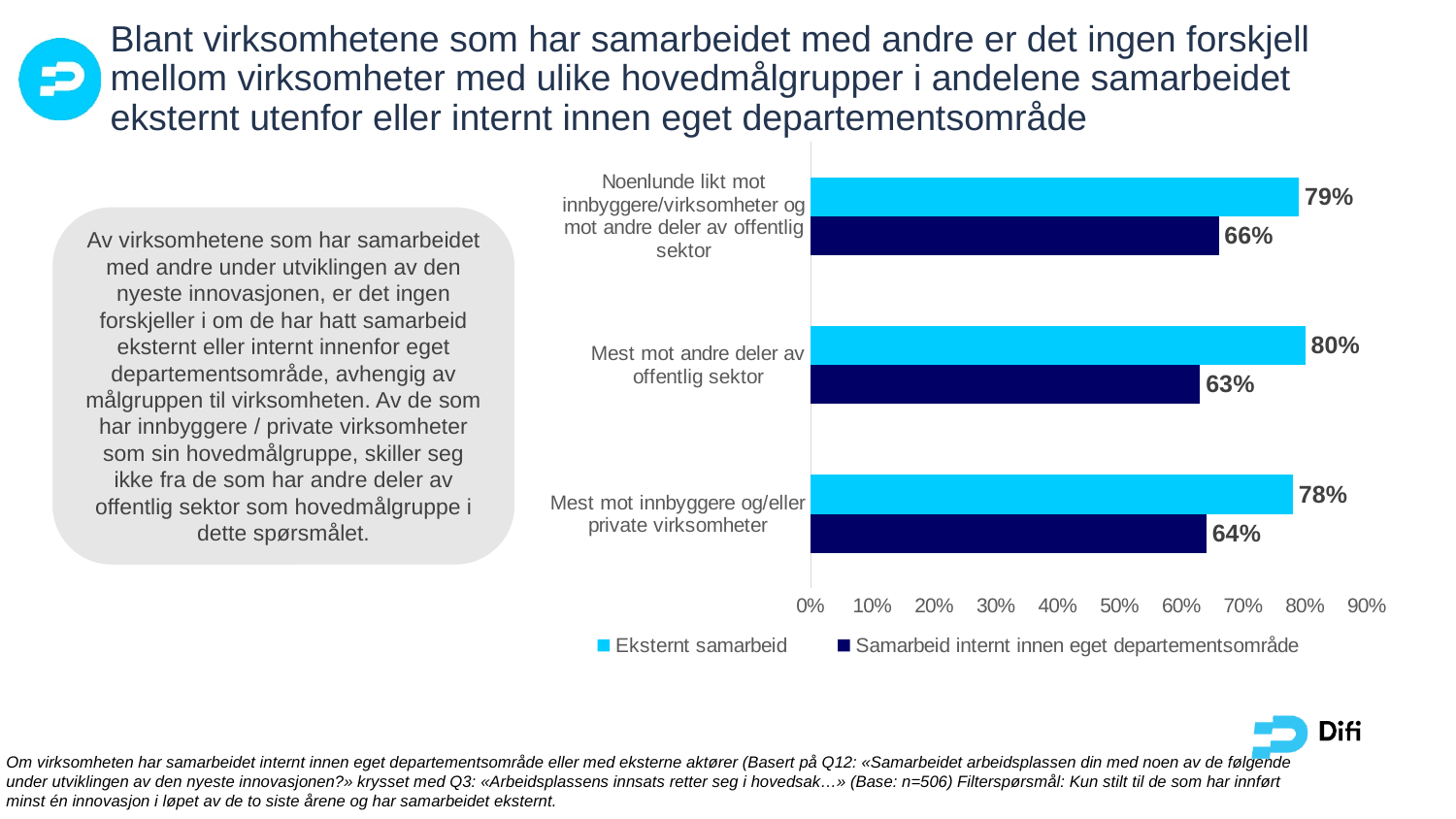
Which category has the highest value for "Eksternt samarbeid"? Mest mot andre deler av offentlig sektor What kind of chart is shown on the slide? Bar chart What is the difference between "Eksternt samarbeid" and "Samarbeid internt innen eget departementsområde" in the category "Mest mot andre deler av offentlig sektor"? 17 percentage points What is the value for "Eksternt samarbeid" in the category "Mest mot andre deler av offentlig sektor"? 80% Is the value for "Samarbeid internt innen eget departementsområde" in the category "Mest mot andre deler av offentlig sektor" greater or less than 70%? less How many series does the legend list? 2 Which colour represents the series "Eksternt samarbeid" in the chart? Light blue What is the value for "Samarbeid internt innen eget departementsområde" in the category "Noenlunde likt mot innbyggere/virksomheter og mot andre deler av offentlig sektor"? 66% In the category "Mest mot innbyggere og/eller private virksomheter", which series has the larger value, "Eksternt samarbeid" or "Samarbeid internt innen eget departementsområde"? Eksternt samarbeid How many categories are shown on the chart? 3 Which category has the lowest value for "Samarbeid internt innen eget departementsområde"? Mest mot andre deler av offentlig sektor What is the value for "Samarbeid internt innen eget departementsområde" in the category "Mest mot innbyggere og/eller private virksomheter"? 64%